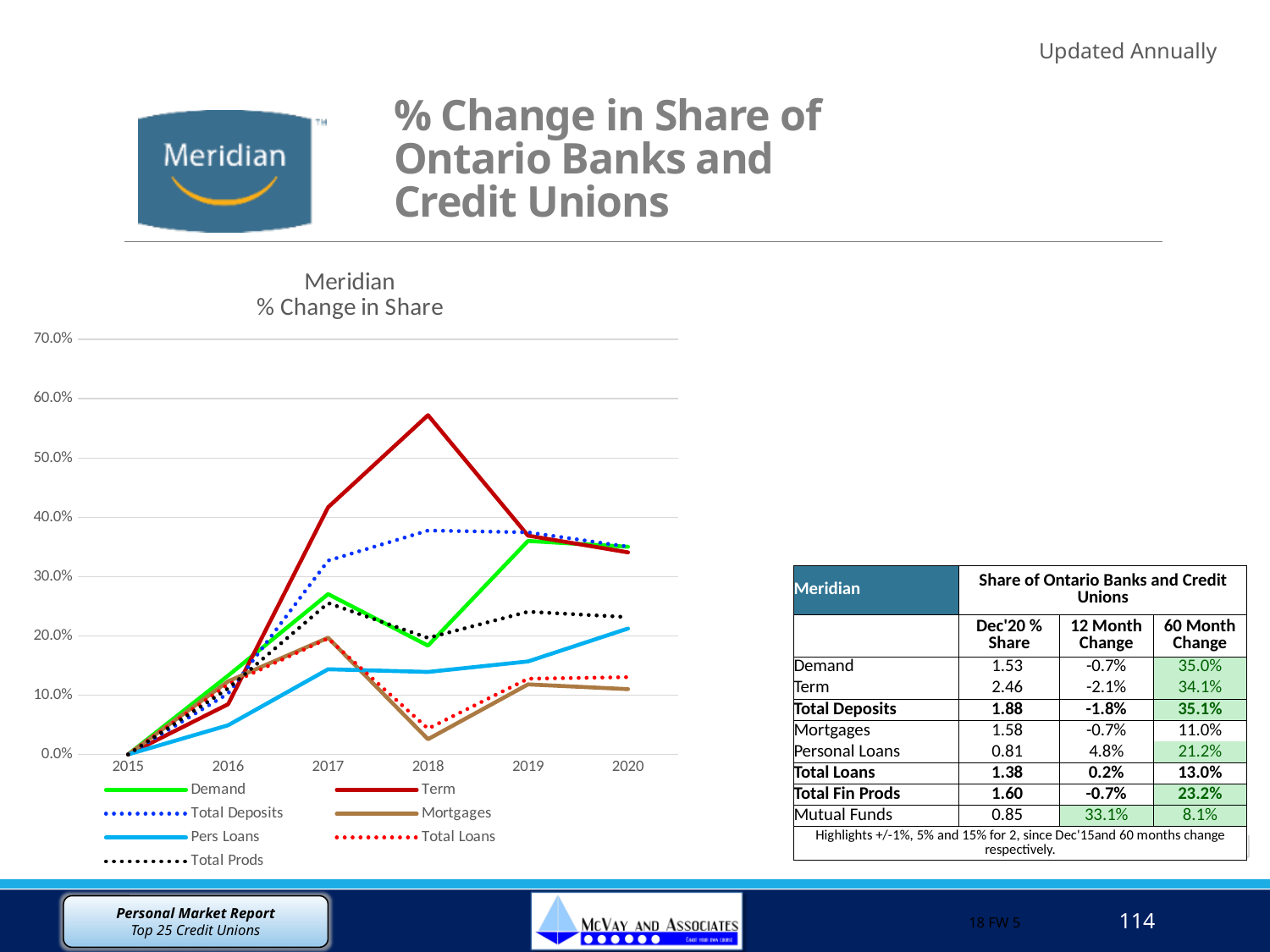
Which series has the highest value in 2018? Term How many series does the chart's legend list? 7 Does the Term series rise or fall from 2018 to 2020? fall What is the value for Demand in 2015? 0.0% How many years are plotted along the x axis of the chart? 6 What kind of chart is shown on the slide? line chart What is the title of the chart? Meridian % Change in Share Is the value for Total Deposits in 2018 greater or less than 30.0%? greater Which series has the lowest value in 2018? Mortgages Is the value for Mortgages in 2018 greater or less than 10.0%? less In 2017, which is larger, the value for Term or the value for Demand? Term Is the value for Term in 2018 greater or less than 50.0%? greater